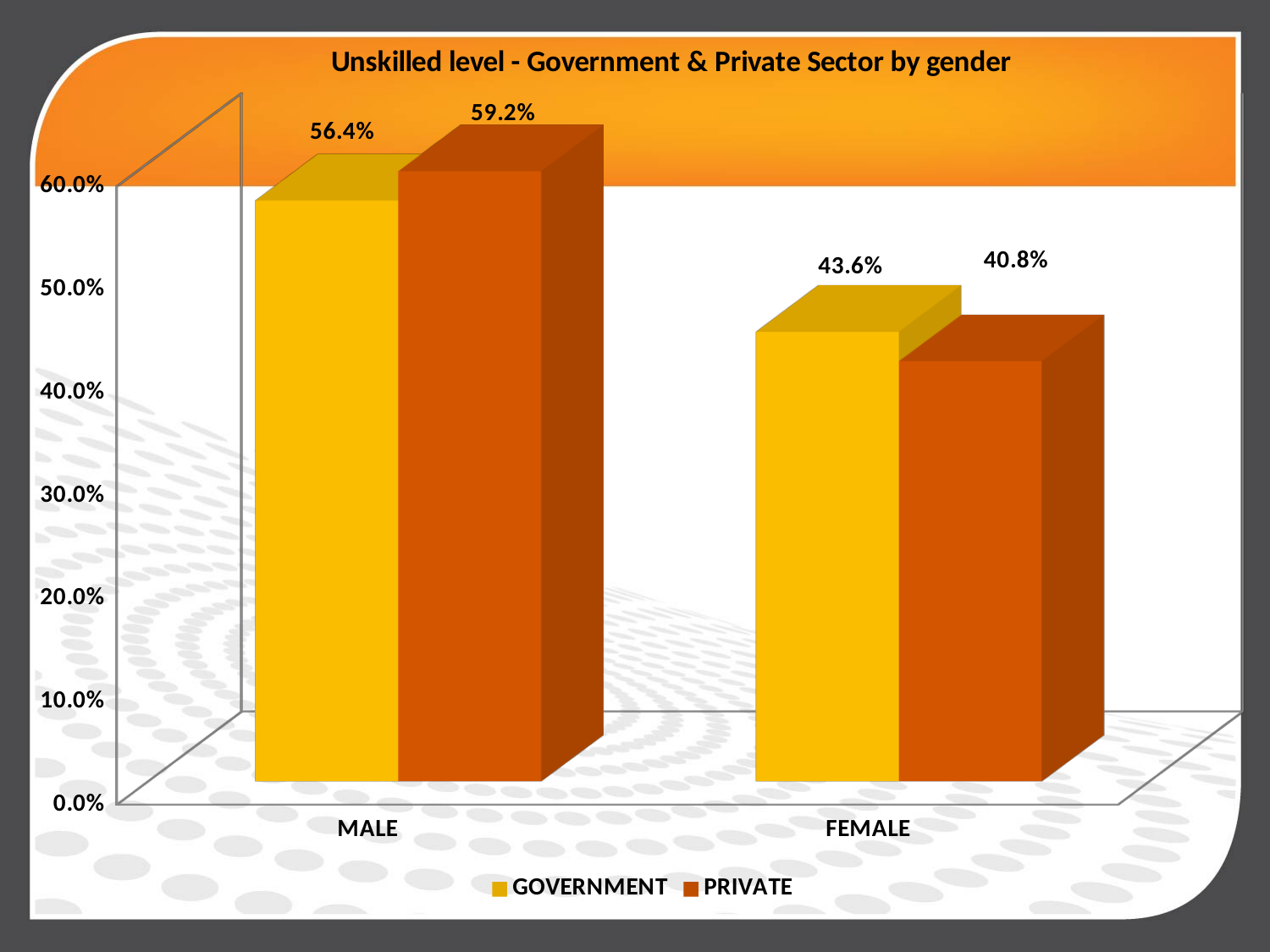
What is the GOVERNMENT value for MALE? 56.4% How many series does the legend list? 2 How many categories are shown on the x axis? 2 What is the PRIVATE value for FEMALE? 40.8% What is the title of the chart? Unskilled level - Government & Private Sector by gender Which category has the highest PRIVATE value? MALE What is the difference between the GOVERNMENT values for MALE and FEMALE? 12.8% What is the difference between the PRIVATE and GOVERNMENT values for MALE? 2.8% Which category has the lowest GOVERNMENT value? FEMALE What is the PRIVATE value for MALE? 59.2% Which is larger for FEMALE, the GOVERNMENT value or the PRIVATE value? GOVERNMENT What is the GOVERNMENT value for FEMALE? 43.6%